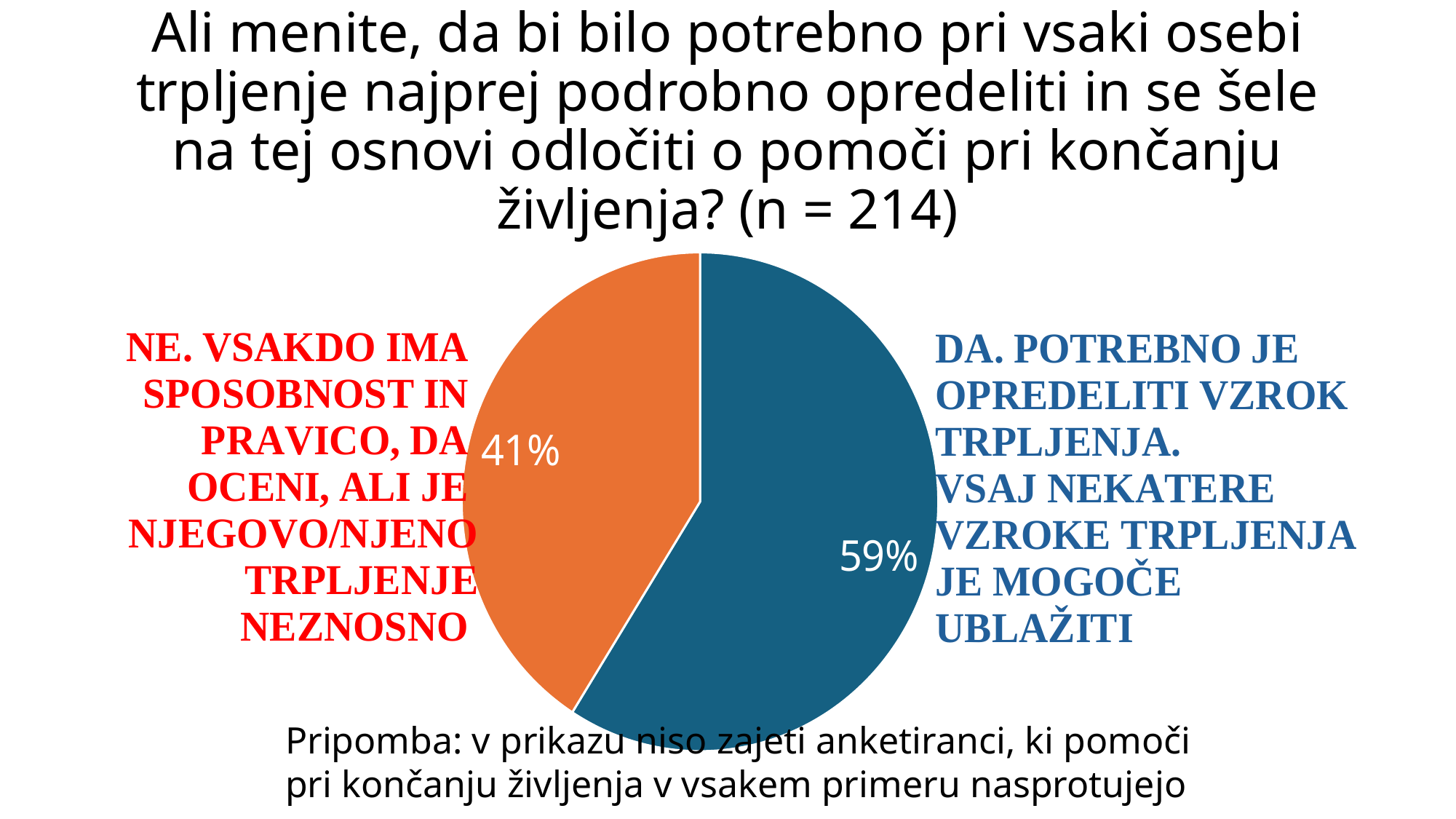
What share of respondents answered "NE" (no, everyone has the ability and right to judge their own suffering)? 41% What kind of chart is shown on the slide? pie chart What colour is the slice representing the "DA" answer? blue Which answer has the larger share of the pie, "DA" or "NE"? DA Is the share for "NE" greater or less than 50%? less What share of respondents answered "DA" (yes, it is necessary to define the cause of suffering)? 59% How many slices does the pie chart have? 2 What is the difference in percentage points between the "DA" and "NE" shares? 18 Which answer has the smaller share of the pie? NE How many respondents (n) does the chart title state? 214 What colour is the slice representing the "NE" answer? orange